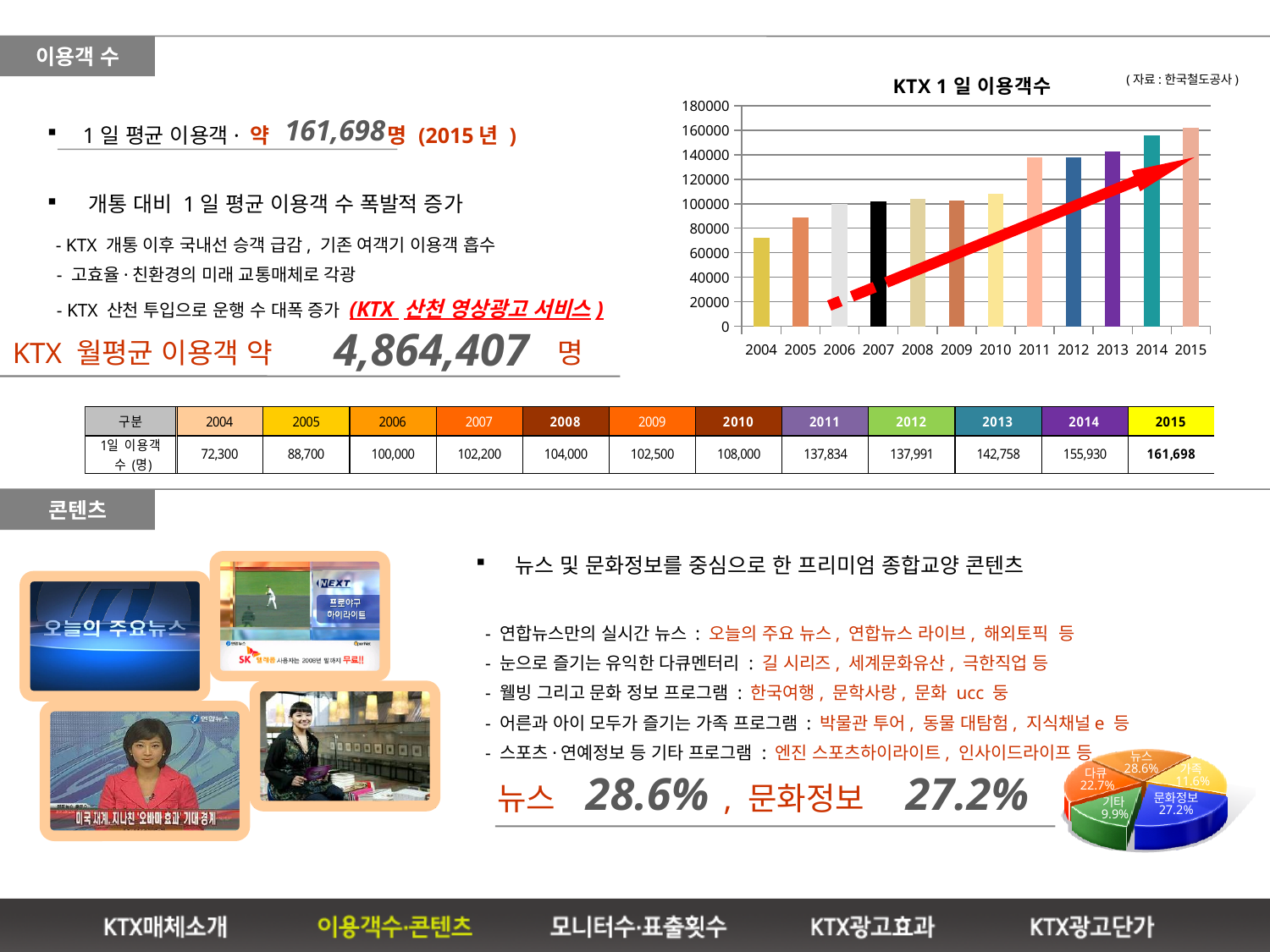
In the pie chart at the bottom right, what share does the '뉴스' slice have? 28.6% How many years are shown on the x axis of the 'KTX 1 일 이용객수' bar chart? 12 In the 'KTX 1 일 이용객수' bar chart, is the value for 2004 greater or less than 80000? less In the pie chart at the bottom right, which slice is the smallest? 기타 In the 'KTX 1 일 이용객수' bar chart, which is larger, the value for 2011 or the value for 2008? 2011 Using the table under the 'KTX 1 일 이용객수' chart, what is the difference between the 2015 and 2004 daily passenger counts? 89,398 What kind of chart is the 'KTX 1 일 이용객수' chart? bar chart Do the values in the 'KTX 1 일 이용객수' bar chart generally rise or fall from 2004 to 2015? rise In the 'KTX 1 일 이용객수' bar chart, which year has the lowest value? 2004 In the 'KTX 1 일 이용객수' bar chart, is the value for 2014 greater or less than 140000? greater In the 'KTX 1 일 이용객수' bar chart, which year has the highest value? 2015 According to the table under the 'KTX 1 일 이용객수' chart, what is the daily passenger count for 2015? 161,698